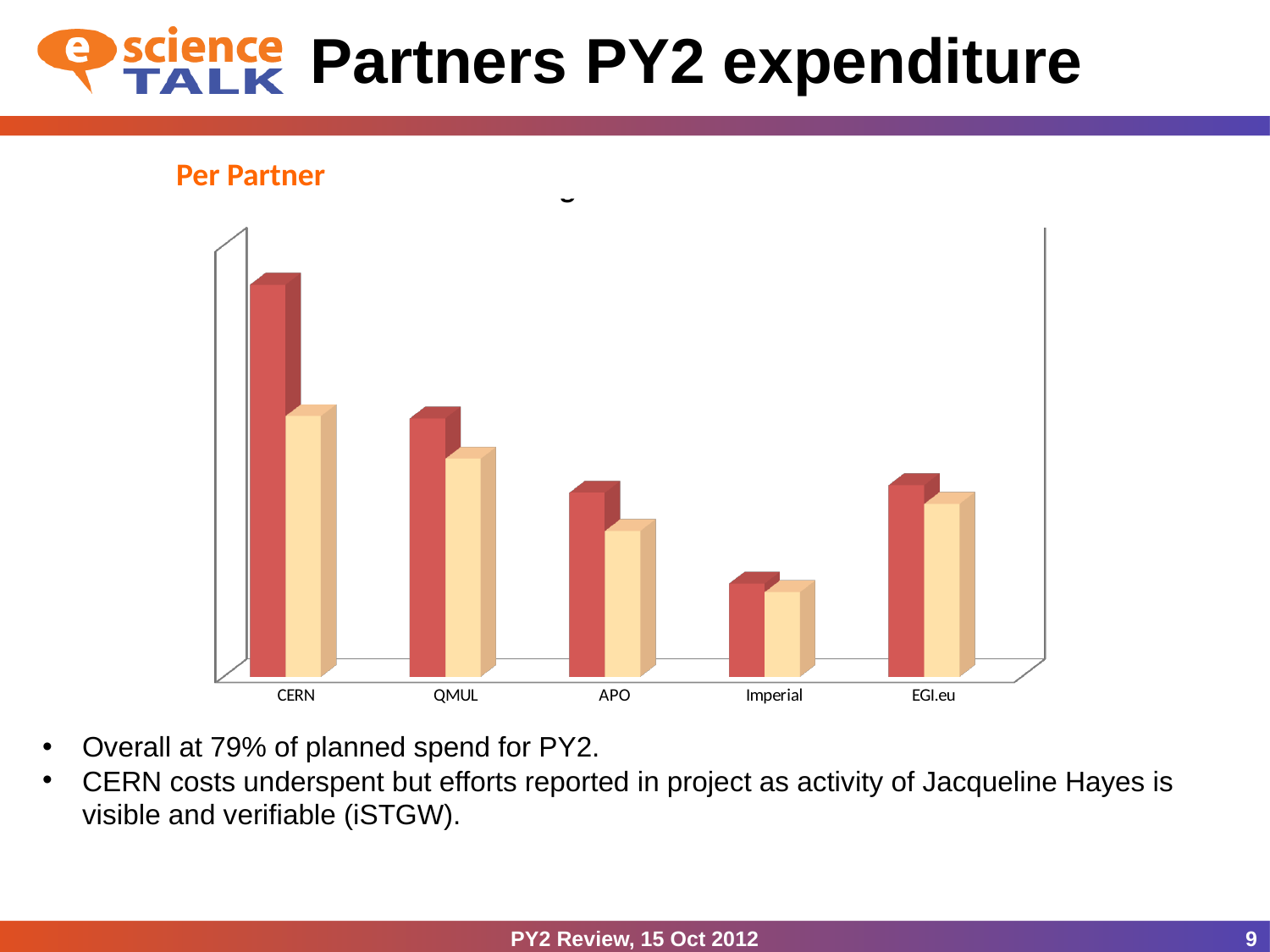
Which partner has the tallest yellow bar in the chart? CERN What is the label of the last category on the x axis of the chart? EGI.eu Which partner has a taller red bar, QMUL or APO? QMUL Which partner has a taller yellow bar, EGI.eu or Imperial? EGI.eu Which partner has the tallest red bar in the chart? CERN Which partner has the shortest yellow bar in the chart? Imperial Which partner has the shortest red bar in the chart? Imperial For CERN, which bar is taller, the red one or the yellow one? red What kind of chart is shown on the slide? bar chart What is the label shown above the chart? Per Partner How many partners (categories) are shown on the x axis of the chart? 5